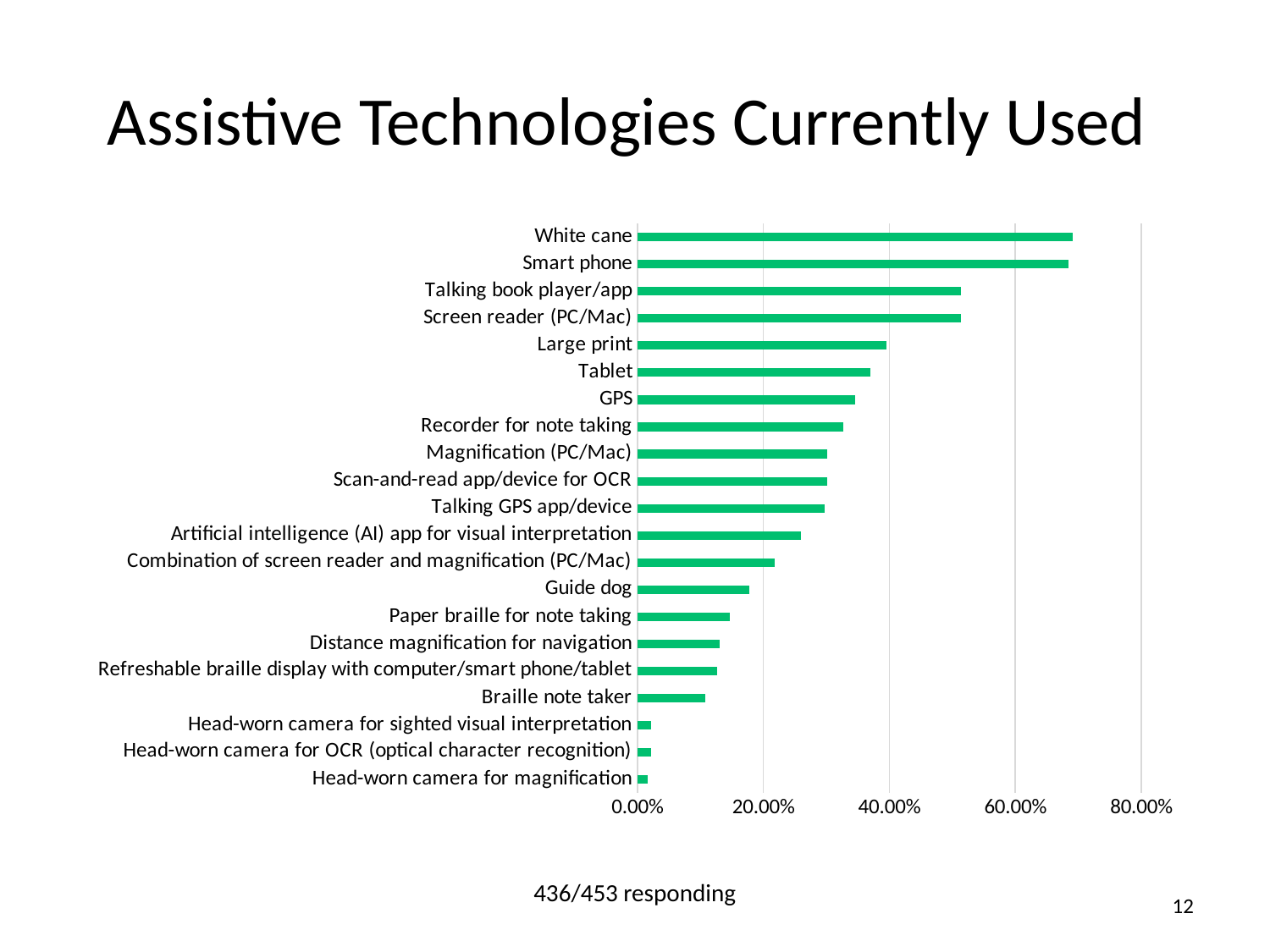
What is the highest value shown on the horizontal axis of the chart? 80.00% Is the value for White cane greater or less than 60.00%? greater Is the value for Head-worn camera for magnification greater or less than 20.00%? less Is the value for Talking book player/app greater or less than 40.00%? greater What is the title of the chart on the slide? Assistive Technologies Currently Used How many assistive technology categories are plotted in the chart? 21 What kind of chart is shown on the slide? bar chart Which has the larger value, Large print or Braille note taker? Large print Which has the larger value, Tablet or Guide dog? Tablet